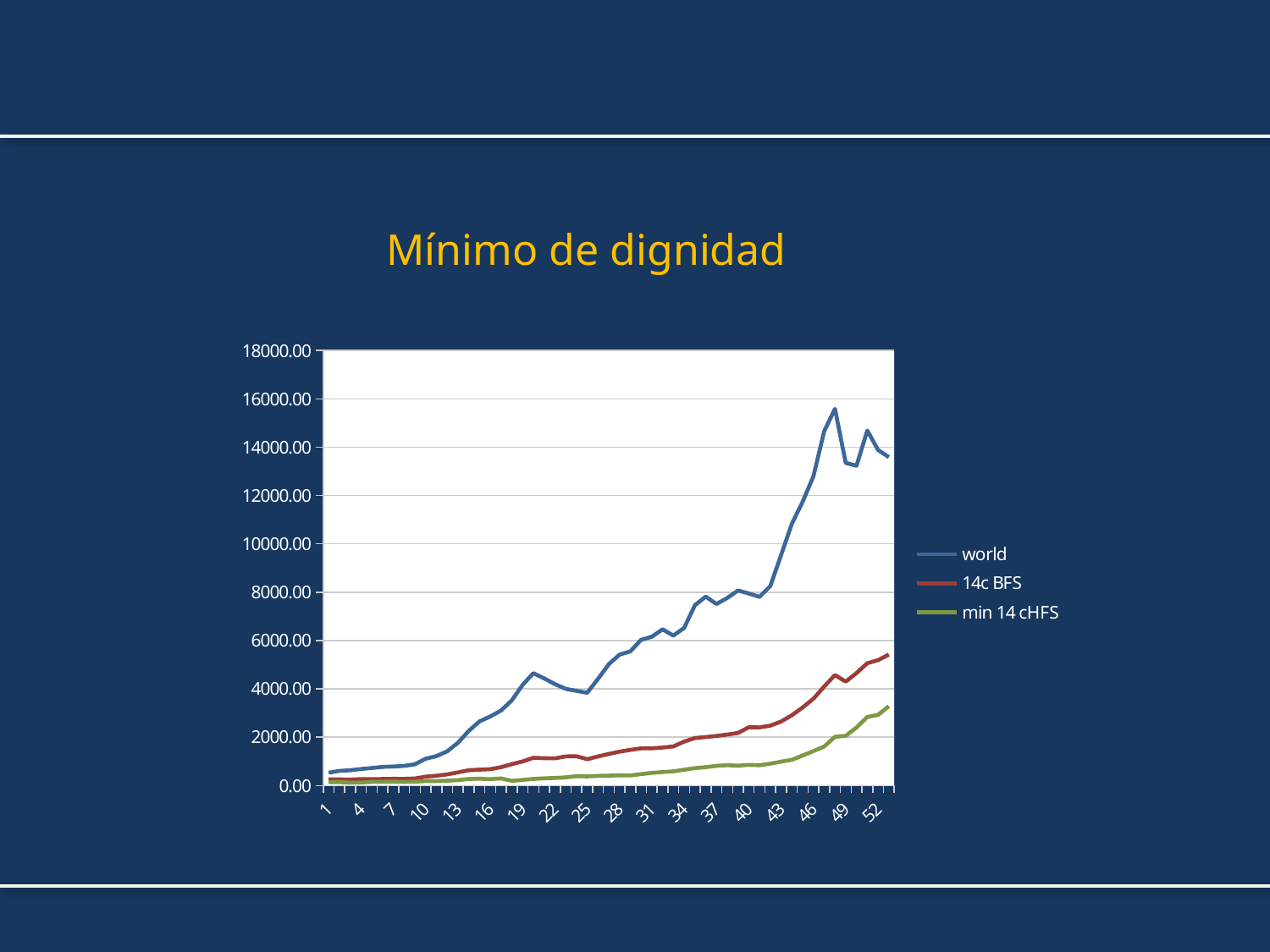
What is the title of the chart? Mínimo de dignidad What kind of chart is shown on the slide? line chart Is the value of the world series at x = 28 greater or less than 4000.00? greater Which series reaches the highest values on the chart? world At x = 52, which series has the larger value, 14c BFS or min 14 cHFS? 14c BFS Is the value of the world series at x = 52 greater or less than 12000.00? greater Does the world series generally rise or fall from x = 1 to x = 52? rise How many series does the legend list? 3 Which series is plotted with the green line? min 14 cHFS Which series has the lowest values across the chart? min 14 cHFS Is the value of the 14c BFS series at x = 52 greater or less than 4000.00? greater